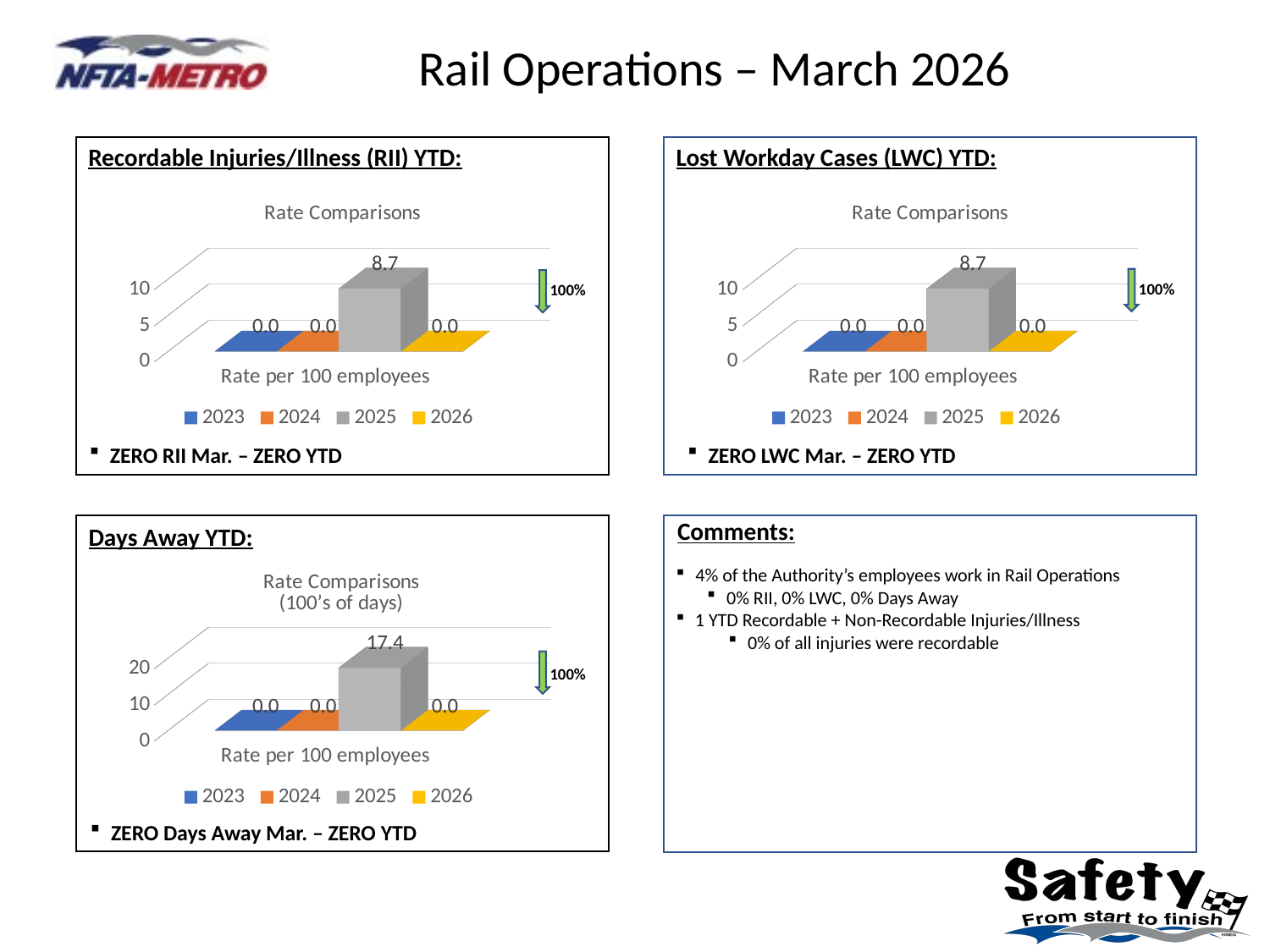
In the Lost Workday Cases (LWC) YTD chart, what is the difference between the 2025 value and the 2024 value? 8.7 In the Recordable Injuries/Illness (RII) YTD chart, what is the value for 2026? 0.0 In the Lost Workday Cases (LWC) YTD chart, is the value for 2025 greater or less than 5? greater In the Days Away YTD chart, what is the value for 2025? 17.4 In the Recordable Injuries/Illness (RII) YTD chart, which year has the highest value? 2025 What kind of chart is the Lost Workday Cases (LWC) YTD chart? bar chart In the Recordable Injuries/Illness (RII) YTD chart, what is the value for 2025? 8.7 In the Lost Workday Cases (LWC) YTD chart, what is the value for 2025? 8.7 What is the title of the Days Away YTD chart? Rate Comparisons (100's of days) In the Days Away YTD chart, what is the difference between the 2025 value and the 2026 value? 17.4 How many series does the legend list in the Recordable Injuries/Illness (RII) YTD chart? 4 In the Days Away YTD chart, which is larger, the value for 2025 or the value for 2023? 2025